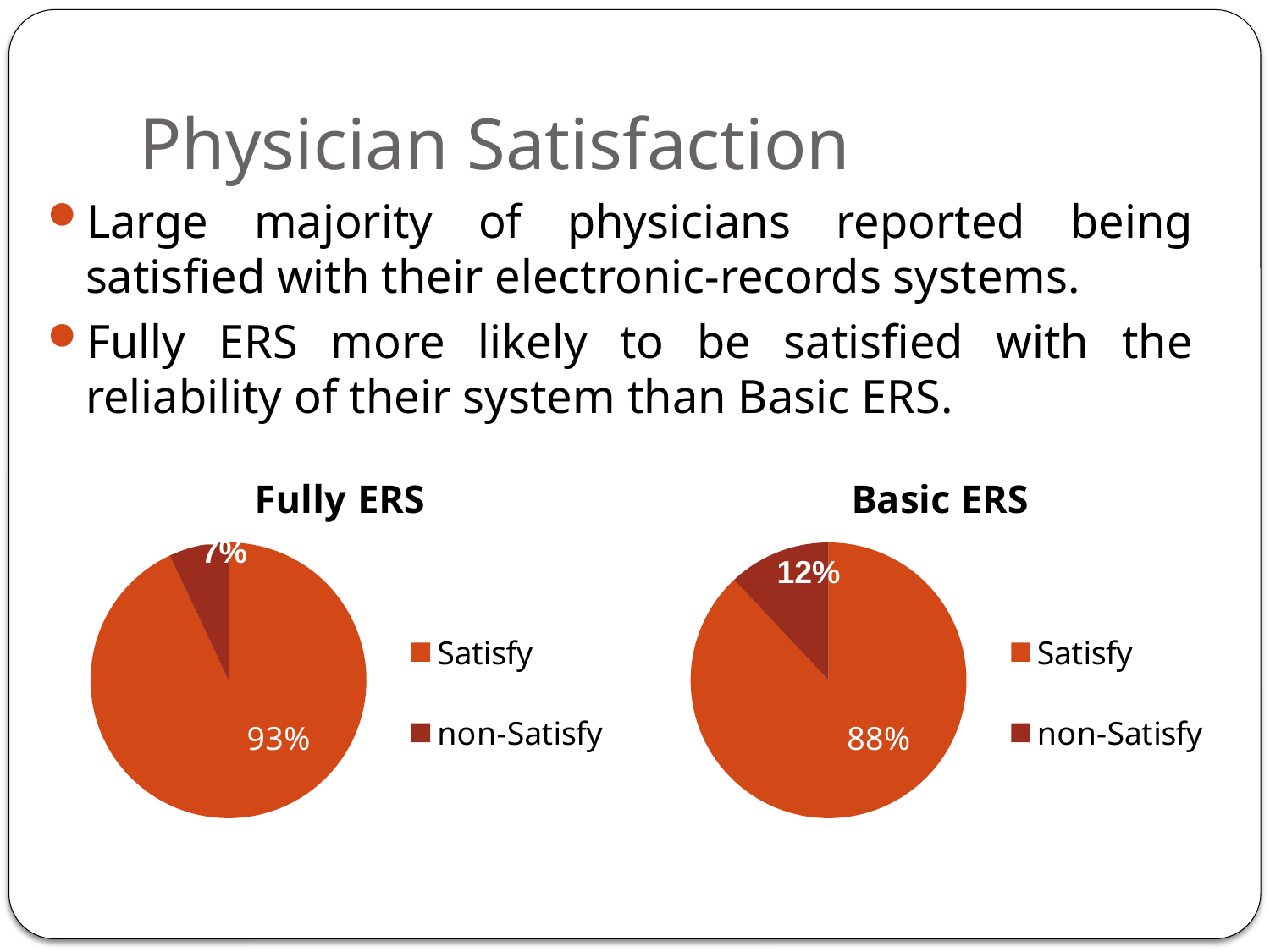
What is the difference between the Satisfy share in the Fully ERS chart and the Satisfy share in the Basic ERS chart? 5% How many slices does the Basic ERS pie chart have? 2 In the Fully ERS chart, what percentage is shown for Satisfy? 93% In the Basic ERS chart, which slice is the largest? Satisfy In the Fully ERS chart, what percentage is shown for non-Satisfy? 7% In the Basic ERS chart, what percentage is shown for Satisfy? 88% Which chart has the larger non-Satisfy share, Fully ERS or Basic ERS? Basic ERS What is the title of the chart on the right side of the slide? Basic ERS In the Basic ERS chart, what percentage is shown for non-Satisfy? 12% How many entries does the legend of the Fully ERS chart list? 2 In the Fully ERS chart, which slice is the smallest? non-Satisfy What type of chart is the Fully ERS chart? Pie chart